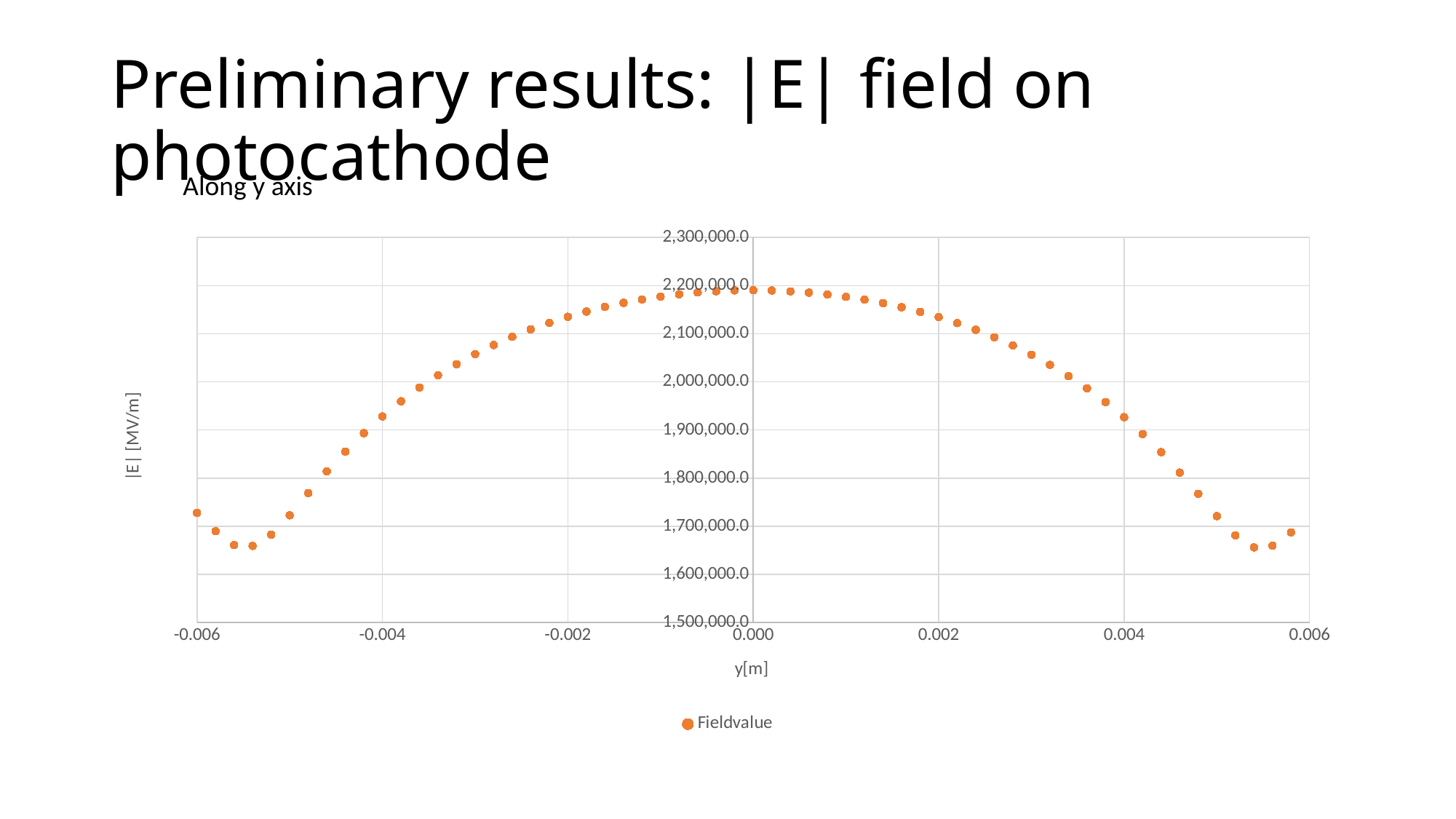
Around which y value does the field reach its highest value? 0.000 Which has the larger field value: y = 0.000 or y = 0.004? y = 0.000 What is the title of the chart? Along y axis Which has the larger field value: y = -0.004 or y = -0.002? y = -0.002 Is the field value at y = 0.004 greater or less than 2,000,000.0? less What is the name of the series shown in the chart legend? Fieldvalue What kind of chart is shown on the slide? Scatter chart Is the field value at y = -0.006 greater or less than 1,800,000.0? less How many series does the chart legend list? 1 Do the field values rise or fall as y goes from 0.000 to 0.006? fall Is the field value at y = 0.000 greater or less than 2,100,000.0? greater